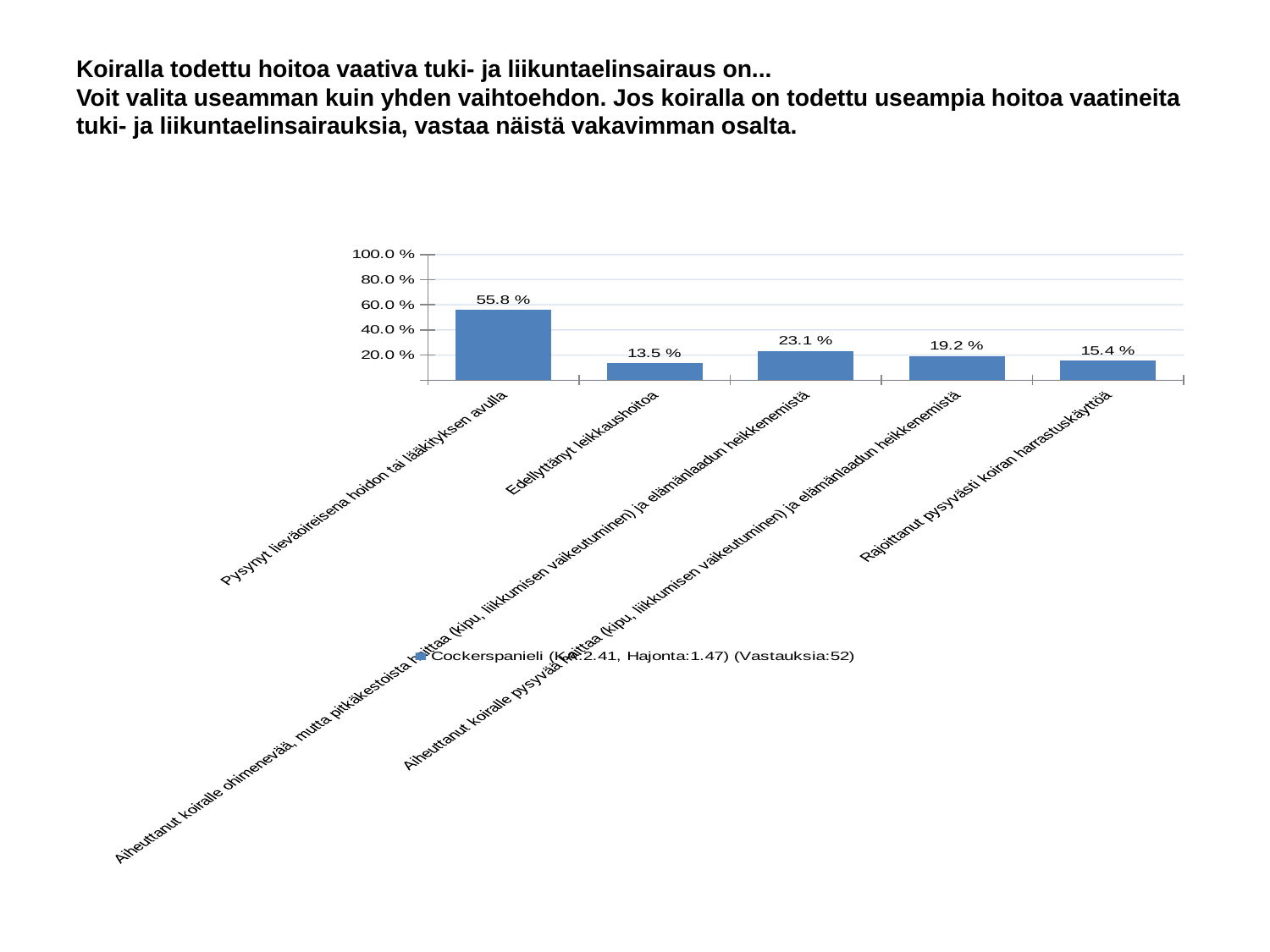
How many responses (Vastauksia) does the legend entry report? 52 What kind of chart is shown on the slide? Bar chart What is the value for "Pysynyt lieväoireisena hoidon tai lääkityksen avulla"? 55.8 % What is the value for "Rajoittanut pysyvästi koiran harrastuskäyttöä"? 15.4 % What is the value for "Edellyttänyt leikkaushoitoa"? 13.5 % Which category has the lowest value? Edellyttänyt leikkaushoitoa Which is larger: the value for the temporary harm category ("Aiheuttanut koiralle ohimenevää, mutta pitkäkestoista haittaa...") or the permanent harm category ("Aiheuttanut koiralle pysyvää haittaa...")? Aiheuttanut koiralle ohimenevää, mutta pitkäkestoista haittaa How many categories are shown on the x axis? 5 Which category has the highest value? Pysynyt lieväoireisena hoidon tai lääkityksen avulla Is the value for "Pysynyt lieväoireisena hoidon tai lääkityksen avulla" greater or less than 40.0 %? greater What is the value for the category about permanent harm ("Aiheuttanut koiralle pysyvää haittaa ... ja elämänlaadun heikkenemistä")? 19.2 % What is the difference between the values for "Pysynyt lieväoireisena hoidon tai lääkityksen avulla" and "Edellyttänyt leikkaushoitoa"? 42.3 %